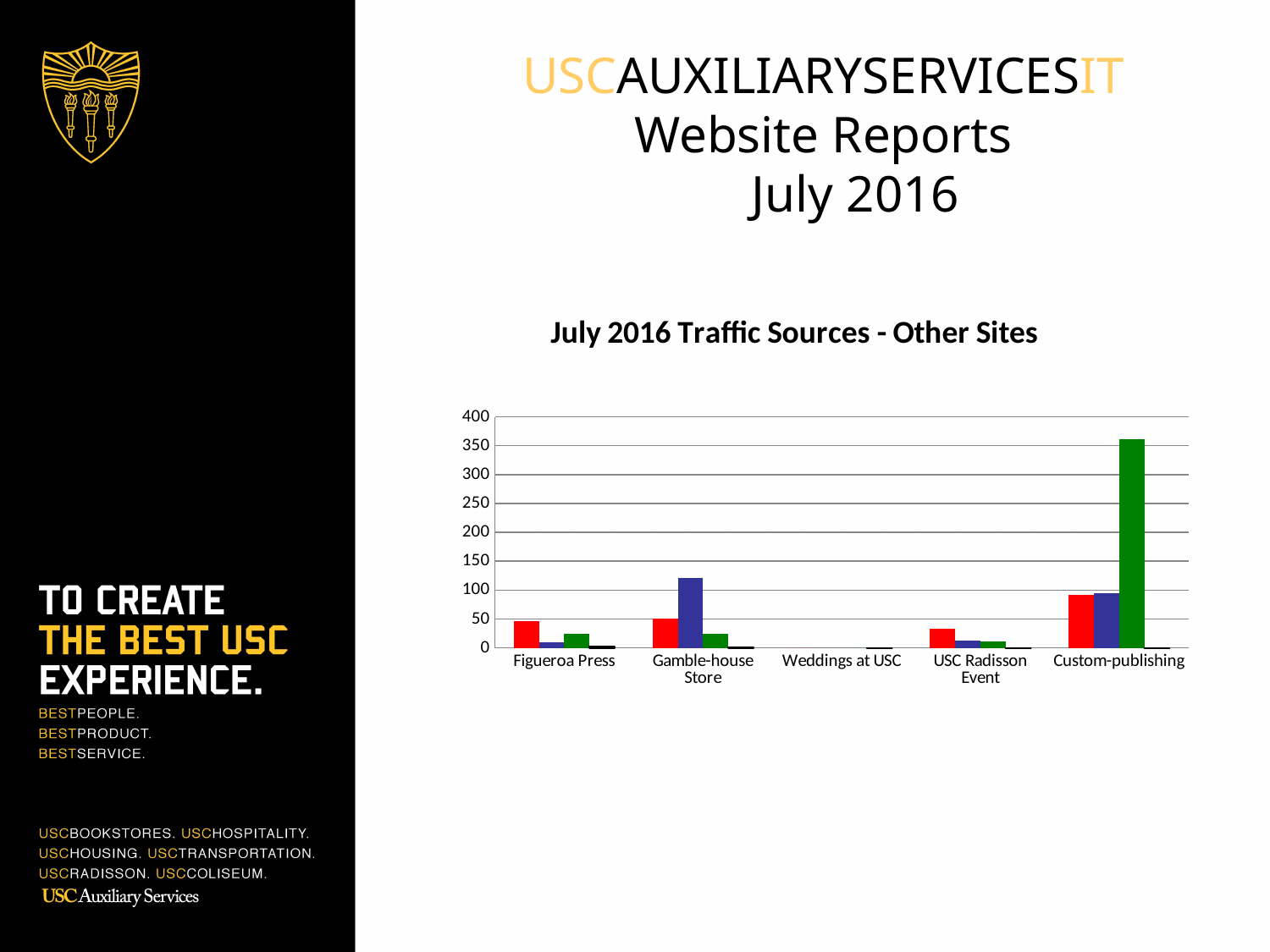
What kind of chart is shown on the slide? bar chart What is the maximum value shown on the y axis of the chart? 400 Is the value of the red bar for USC Radisson Event greater or less than 50? less Is the value of the red bar for Figueroa Press greater or less than 100? less Which category has the tallest bar in the chart? Custom-publishing Is the value of the green bar for Custom-publishing greater or less than 400? less Which is larger: the blue bar for Gamble-house Store or the blue bar for Figueroa Press? Gamble-house Store Which is larger: the green bar for Custom-publishing or the blue bar for Gamble-house Store? Custom-publishing How many categories are shown on the x axis of the chart? 5 What is the title of the chart? July 2016 Traffic Sources - Other Sites